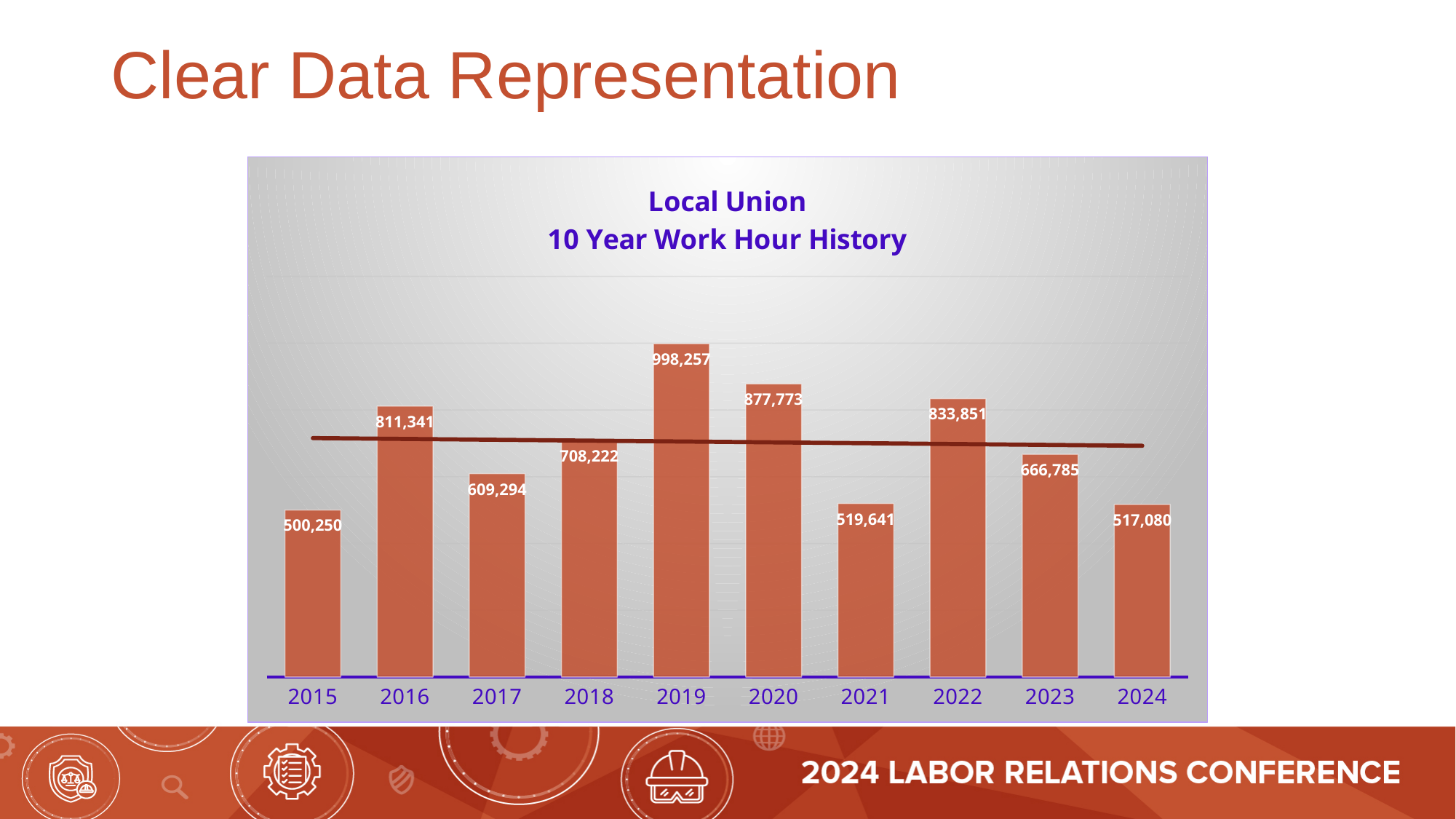
What kind of chart is this? bar chart What is the value for 2019? 998,257 Which year has the highest value? 2019 What is the value for 2022? 833,851 What is the value for 2015? 500,250 Which is larger, the value for 2018 or the value for 2023? 2018 Which year has the lowest value? 2015 What is the difference between the values for 2020 and 2021? 358,132 What is the title of the chart? Local Union 10 Year Work Hour History What is the difference between the values for 2019 and 2015? 498,007 Which is larger, the value for 2017 or the value for 2020? 2020 How many years are shown on the x axis? 10